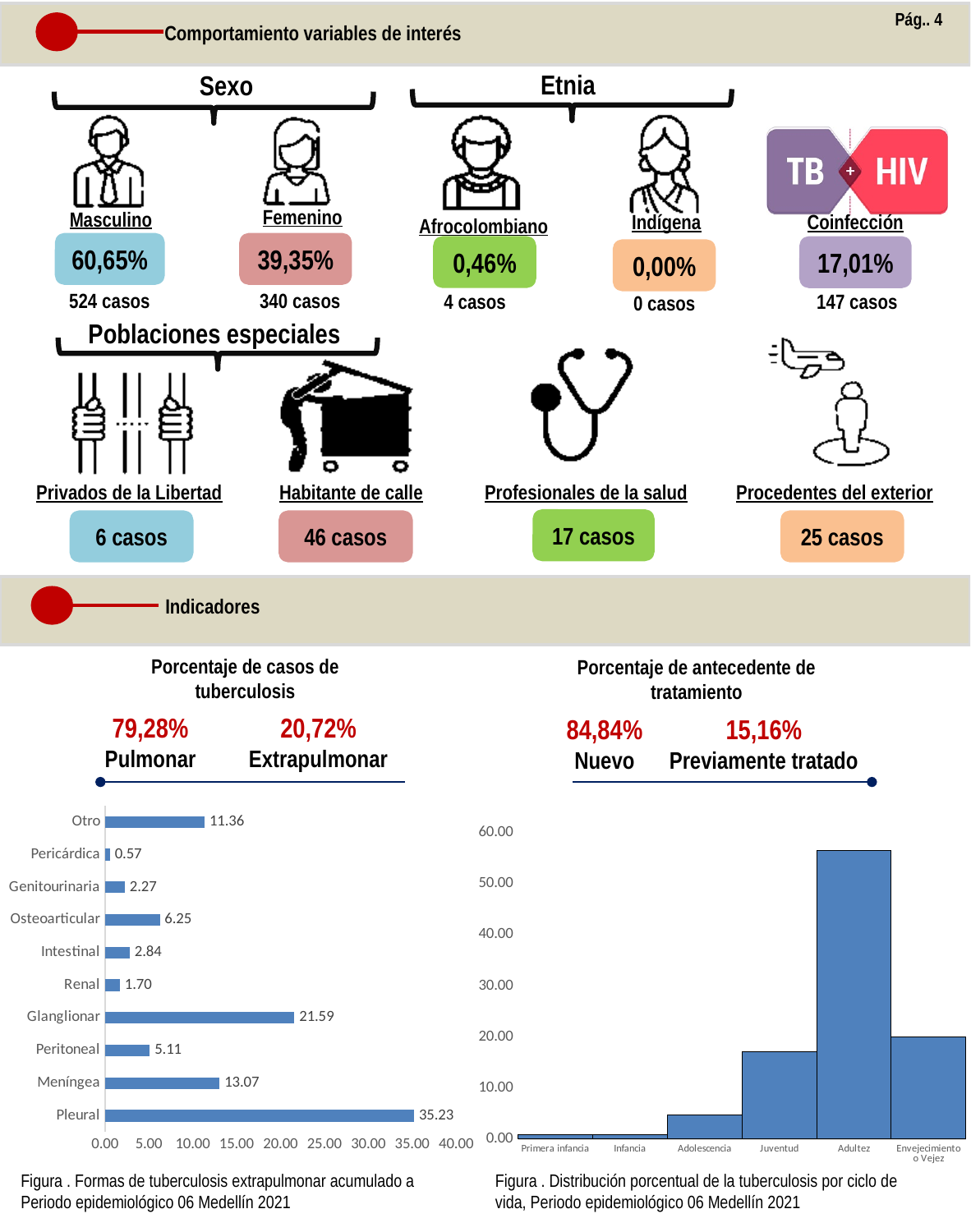
In the chart 'Distribución porcentual de la tuberculosis por ciclo de vida, Periodo epidemiológico 06 Medellín 2021', is the value for Juventud greater or less than 20.00? less In the chart 'Formas de tuberculosis extrapulmonar acumulado a Periodo epidemiológico 06 Medellín 2021', what is the difference between the values for Pleural and Glanglionar? 13.64 In the chart 'Distribución porcentual de la tuberculosis por ciclo de vida, Periodo epidemiológico 06 Medellín 2021', which category has the highest value? Adultez In the chart 'Distribución porcentual de la tuberculosis por ciclo de vida, Periodo epidemiológico 06 Medellín 2021', is the value for Adultez greater or less than 50.00? greater In the chart 'Formas de tuberculosis extrapulmonar acumulado a Periodo epidemiológico 06 Medellín 2021', what is the value for Glanglionar? 21.59 In the chart 'Formas de tuberculosis extrapulmonar acumulado a Periodo epidemiológico 06 Medellín 2021', what is the value for Meníngea? 13.07 In the chart 'Formas de tuberculosis extrapulmonar acumulado a Periodo epidemiológico 06 Medellín 2021', which category has the highest value? Pleural How many categories are shown in the chart 'Formas de tuberculosis extrapulmonar acumulado a Periodo epidemiológico 06 Medellín 2021'? 10 In the chart 'Formas de tuberculosis extrapulmonar acumulado a Periodo epidemiológico 06 Medellín 2021', which is larger, Osteoarticular or Peritoneal? Osteoarticular How many categories are shown on the x axis of the chart 'Distribución porcentual de la tuberculosis por ciclo de vida, Periodo epidemiológico 06 Medellín 2021'? 6 What kind of chart is 'Formas de tuberculosis extrapulmonar acumulado a Periodo epidemiológico 06 Medellín 2021'? Bar chart In the chart 'Formas de tuberculosis extrapulmonar acumulado a Periodo epidemiológico 06 Medellín 2021', which category has the lowest value? Pericárdica